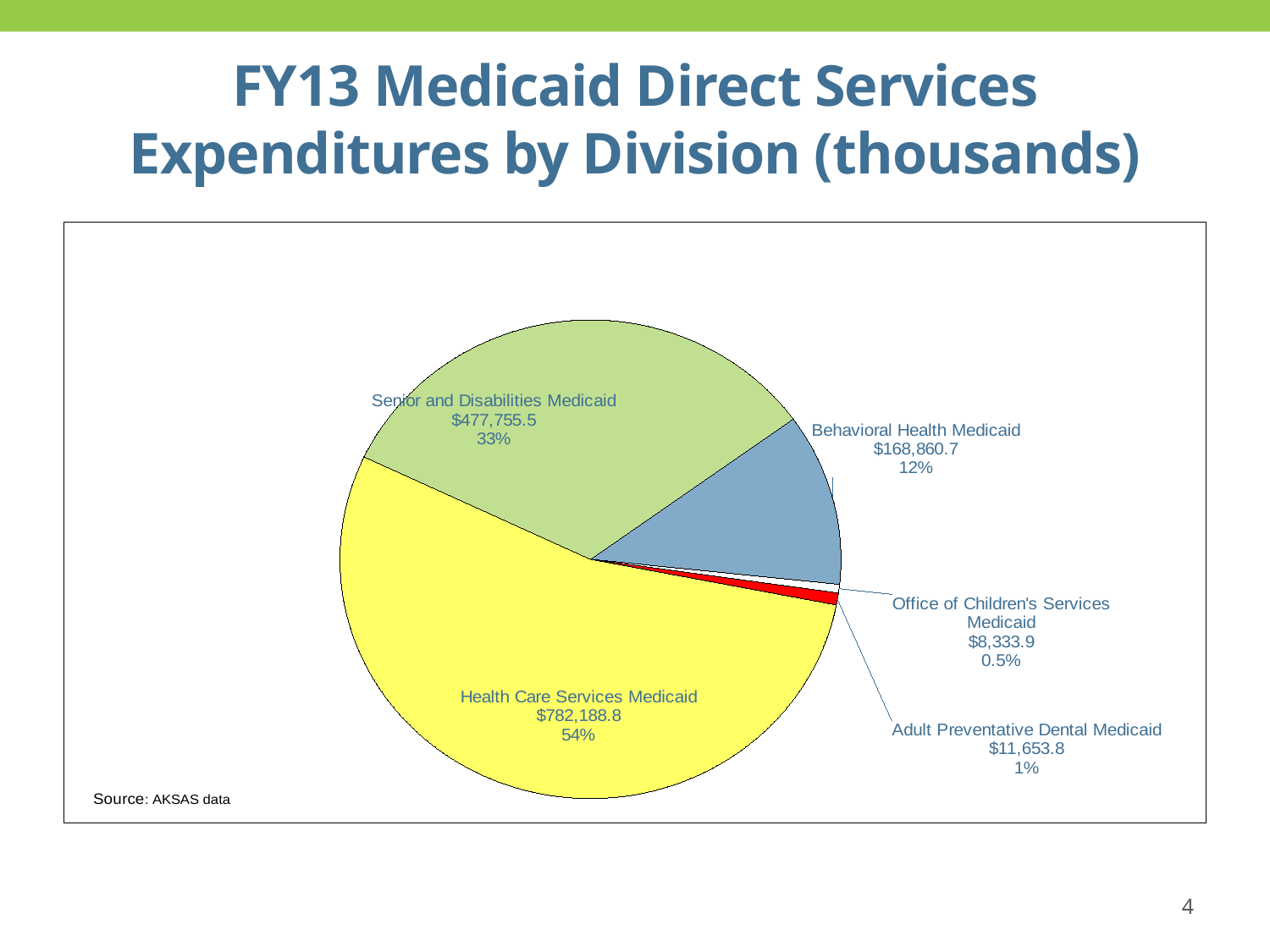
What kind of chart is shown on the slide? pie chart Which is larger, Adult Preventative Dental Medicaid or Office of Children's Services Medicaid? Adult Preventative Dental Medicaid What is the value for Behavioral Health Medicaid? $168,860.7 What is the value for Office of Children's Services Medicaid? $8,333.9 What share of the pie does Senior and Disabilities Medicaid represent? 33% What is the value for Adult Preventative Dental Medicaid? $11,653.8 Which division has the smallest expenditure? Office of Children's Services Medicaid What is the value for Health Care Services Medicaid? $782,188.8 How many slices does the pie chart have? 5 What share of the pie does Behavioral Health Medicaid represent? 12% Which division has the largest expenditure? Health Care Services Medicaid What is the value for Senior and Disabilities Medicaid? $477,755.5